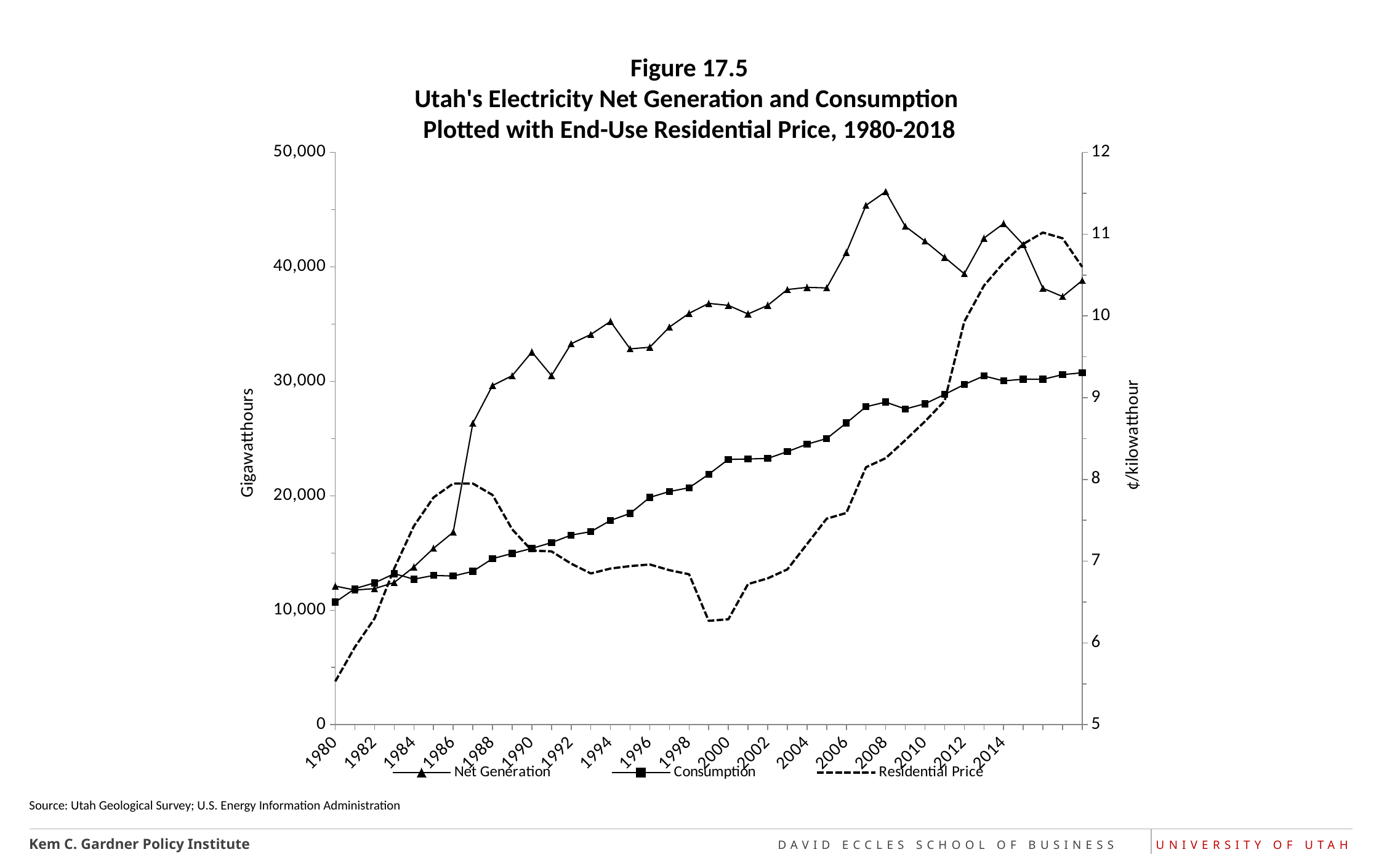
How many series does the legend list? 3 In which year does Net Generation reach its highest value? 2008 What kind of chart is shown on the slide? Line chart Is the value for Net Generation in 2008 greater or less than 40,000? greater Is the Residential Price in 2000 greater or less than 7? less What unit is shown on the left-hand vertical axis? Gigawatthours In which year is Consumption at its lowest? 1980 Is the value for Consumption in 2000 greater or less than 20,000? greater Which is larger in 2008, Net Generation or Consumption? Net Generation What unit is shown on the right-hand vertical axis? ¢/kilowatthour